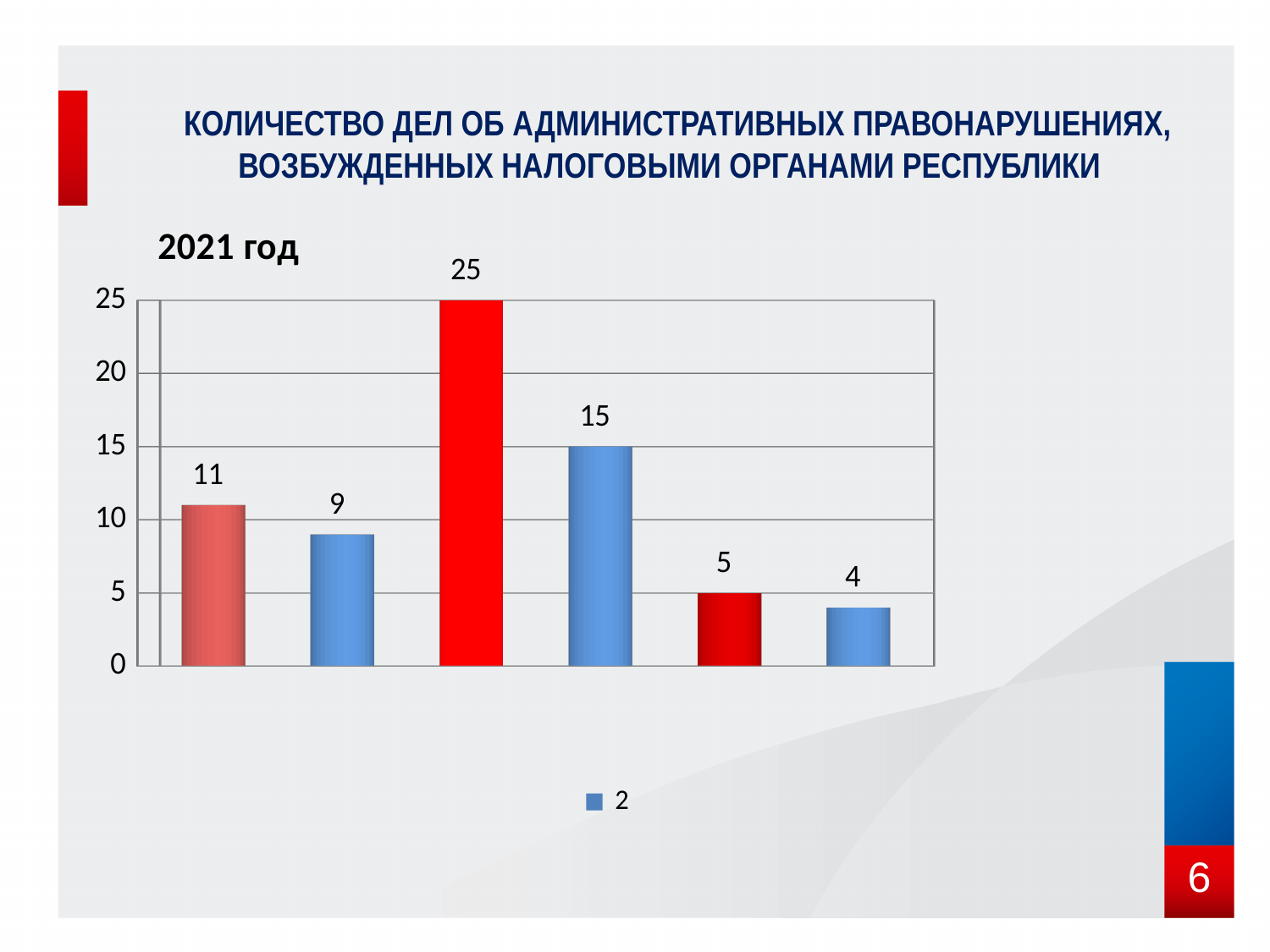
What is the value shown on the second bar from the left? 9 What is the value of the tallest bar in the chart? 25 What is the value shown on the fifth bar from the left? 5 What kind of chart is shown on the slide? bar chart How many bars are plotted in the chart? 6 What is the value shown on the fourth bar from the left? 15 What is the value of the shortest bar in the chart? 4 Which is larger, the first bar or the second bar? the first bar (11) What entry does the legend below the chart show? 2 What is the value shown on the first (leftmost) bar? 11 What is the difference between the third bar (25) and the fourth bar (15)? 10 What year is shown in the chart's title? 2021 год